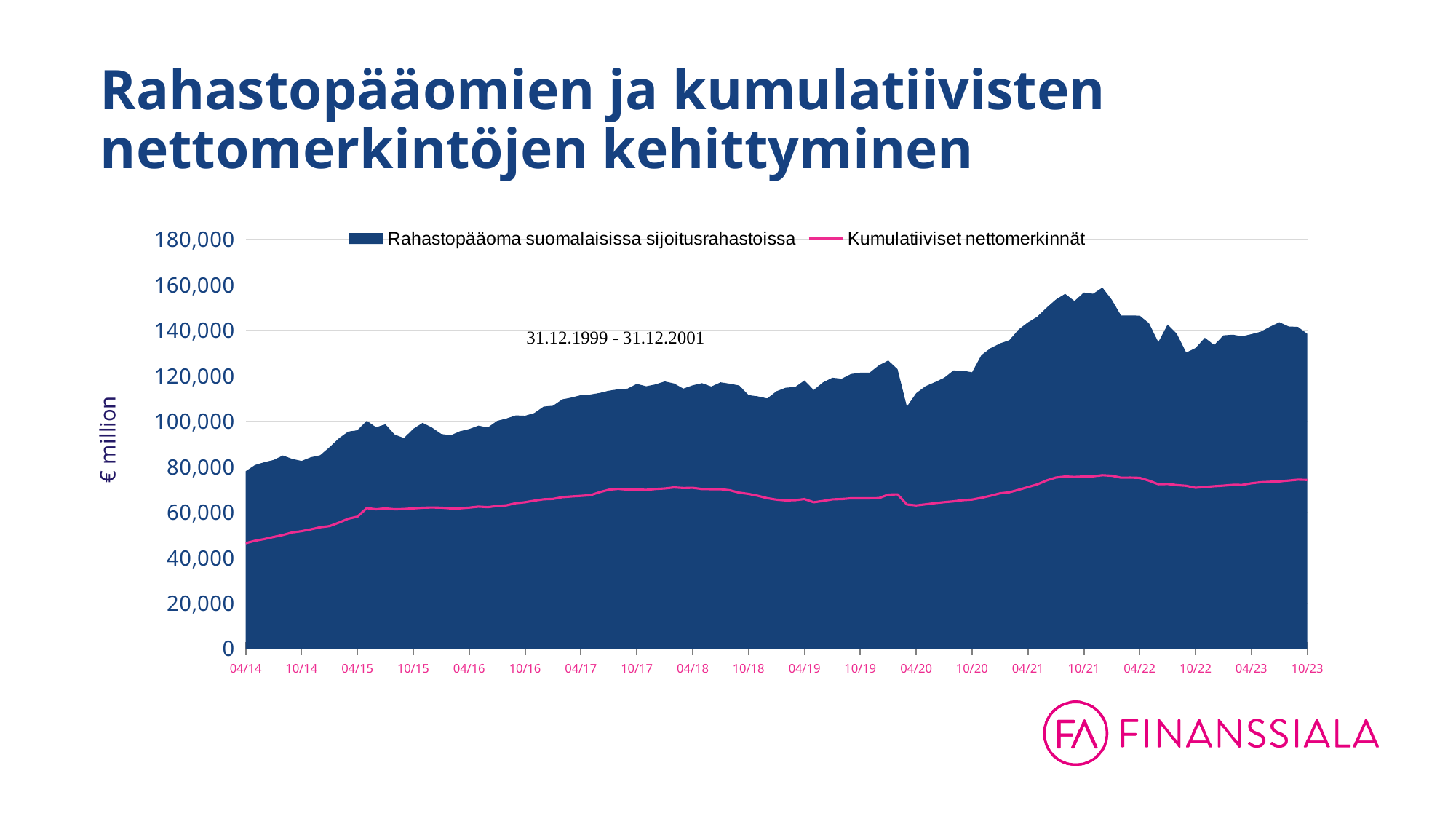
What kind of chart is shown on the slide? An area chart with a line series Is the value of Rahastopääoma suomalaisissa sijoitusrahastoissa at 04/16 greater or less than 80,000? greater How many series does the legend list? 2 Overall, does Kumulatiiviset nettomerkinnät rise or fall from 04/14 to 10/23? rise What unit is shown on the vertical axis label? € million Overall, does Rahastopääoma suomalaisissa sijoitusrahastoissa rise or fall from 04/14 to 10/23? rise At 10/23, which series has the higher value: Rahastopääoma suomalaisissa sijoitusrahastoissa or Kumulatiiviset nettomerkinnät? Rahastopääoma suomalaisissa sijoitusrahastoissa Is the value of Rahastopääoma suomalaisissa sijoitusrahastoissa at 04/18 greater or less than 100,000? greater Is the value of Kumulatiiviset nettomerkinnät at 10/23 greater or less than 60,000? greater What are the two series named in the legend? Rahastopääoma suomalaisissa sijoitusrahastoissa; Kumulatiiviset nettomerkinnät